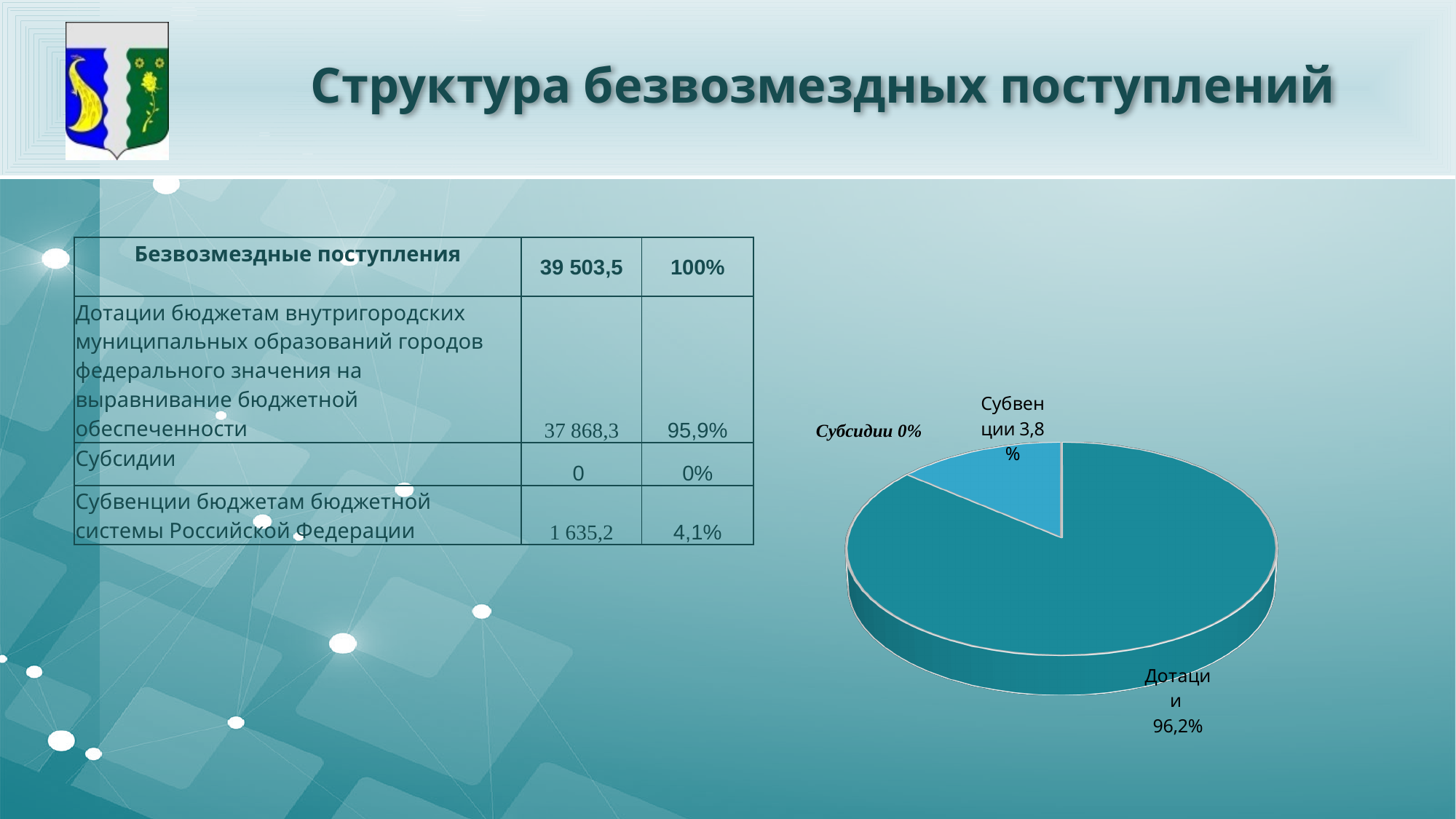
How many categories are labelled in the pie chart? 3 Which category has the largest slice in the pie chart? Дотации Which is larger in the pie chart, Дотации or Субвенции? Дотации What share of the pie chart does Субсидии have? 0% Is the share for Дотации in the pie chart greater or less than 50%? greater Which slice of the pie chart is drawn in the lighter blue colour? Субвенции What kind of chart is shown on the slide? Pie chart What share of the pie chart does Субвенции have? 3,8% What is the difference in percentage points between the Дотации and Субвенции slices in the pie chart? 92,4 Which category has the smallest slice in the pie chart? Субсидии What is the title of the slide containing the pie chart? Структура безвозмездных поступлений What share of the pie chart does Дотации have? 96,2%